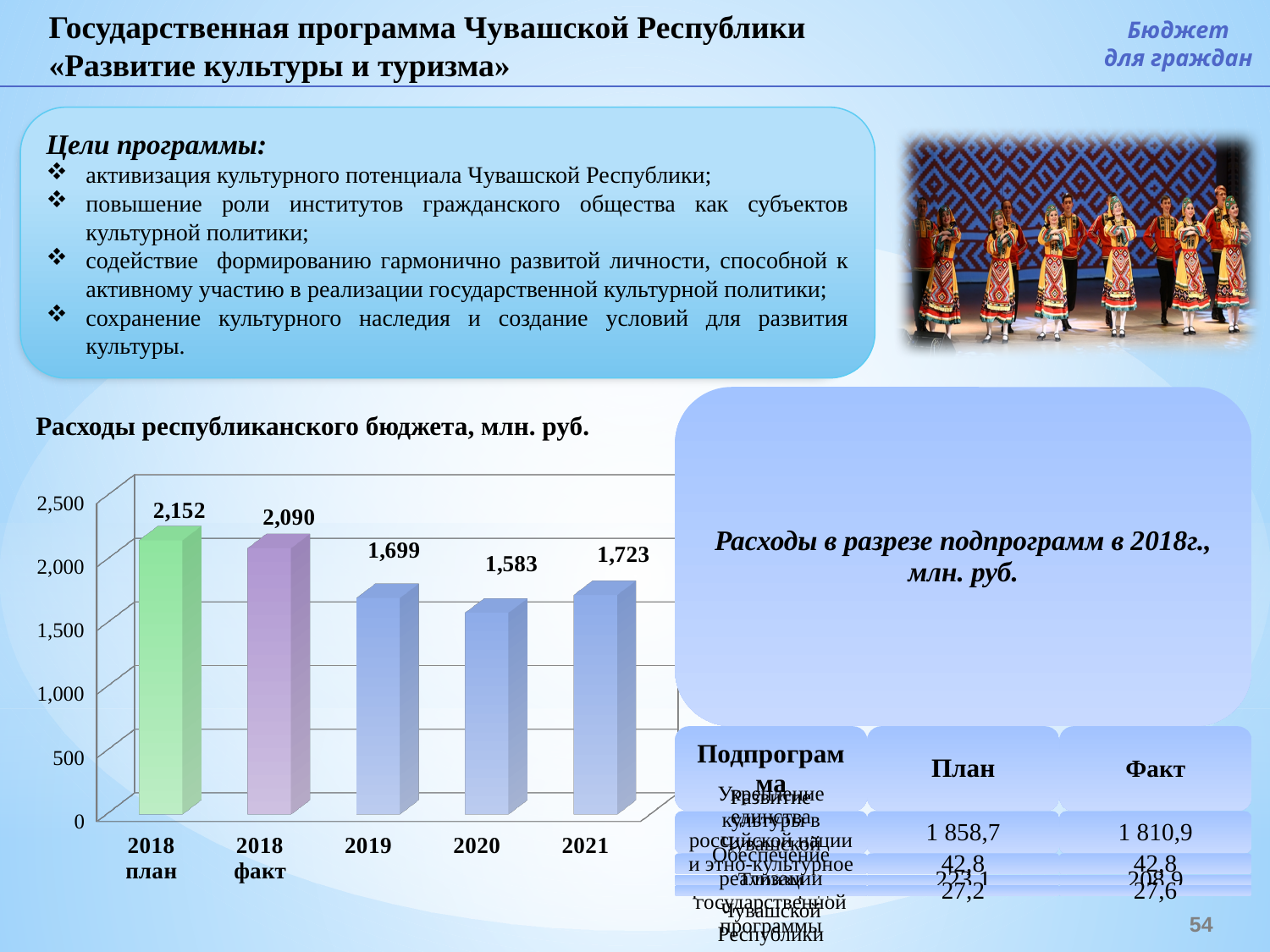
What is the value for 2020 in the chart? 1,583 What kind of chart is used to show the republican budget expenditures? bar chart How many bars are shown in the chart? 5 Which category has the highest value in the chart? 2018 план What is the value for 2021 in the chart? 1,723 What is the difference between the 2018 план and 2018 факт values? 62 What is the value for 2018 факт in the chart? 2,090 Is the value for 2019 greater or less than 2,000? less What is the value for 2018 план in the chart 'Расходы республиканского бюджета, млн. руб.'? 2,152 What is the difference between the 2021 and 2020 values? 140 Which category has the lowest value in the chart? 2020 Which is larger, the value for 2019 or the value for 2021? 2021